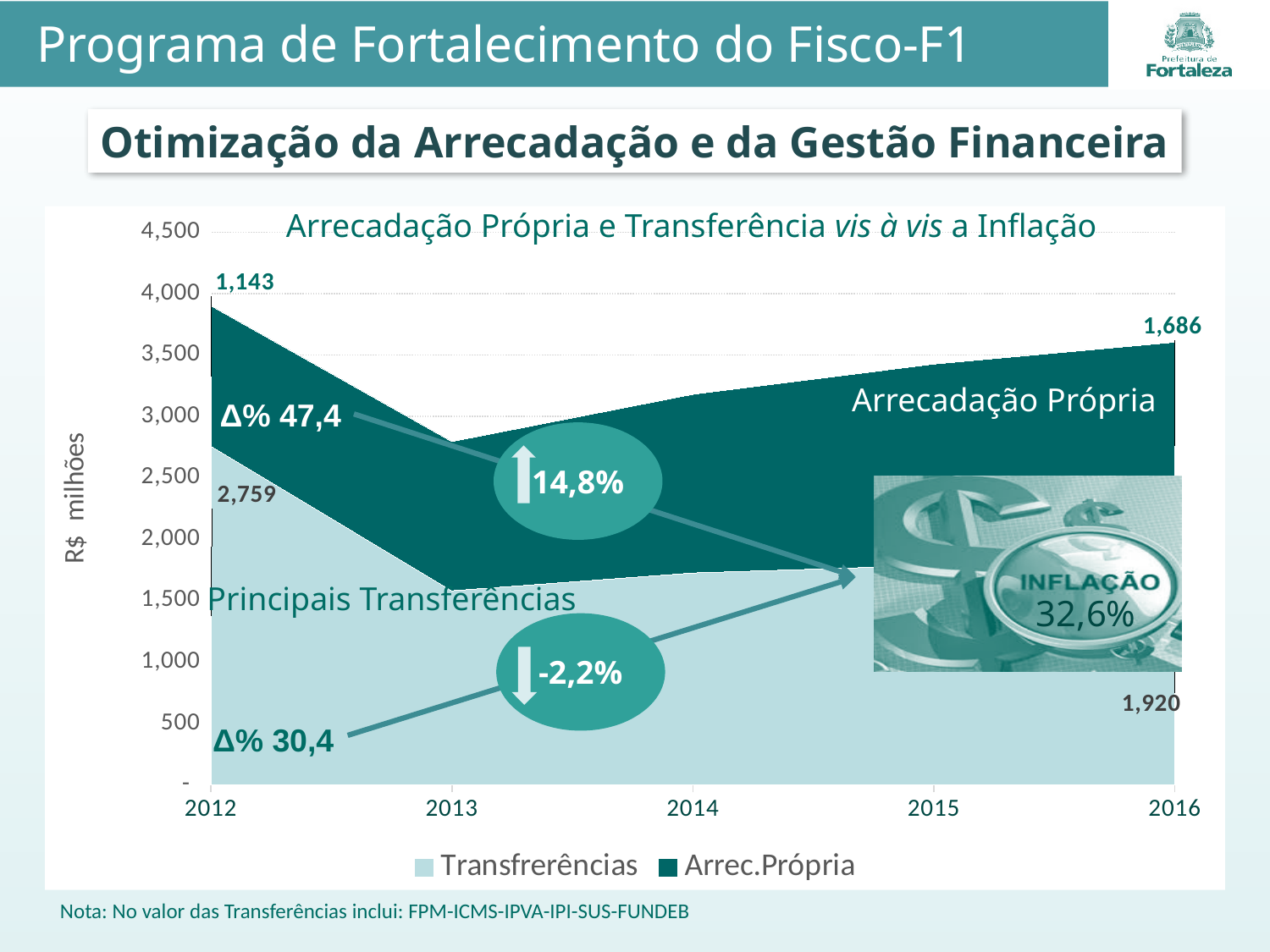
What is the value for Arrec.Própria in 2012? 1,143 How many years are shown on the x axis? 5 What is the value for Arrec.Própria in 2016? 1,686 What is the value for Transfrerências in 2016? 1,920 By how much did Arrec.Própria increase from 2012 to 2016? 543 In 2012, which is larger: Transfrerências or Arrec.Própria? Transfrerências By how much did Transfrerências decrease from 2012 to 2016? 839 What is the combined total of Transfrerências and Arrec.Própria in 2016? 3,606 What is the value for Transfrerências in 2012? 2,759 What is the combined total of Transfrerências and Arrec.Própria in 2012? 3,902 What kind of chart is shown on the slide? Area chart How many series does the legend list? 2